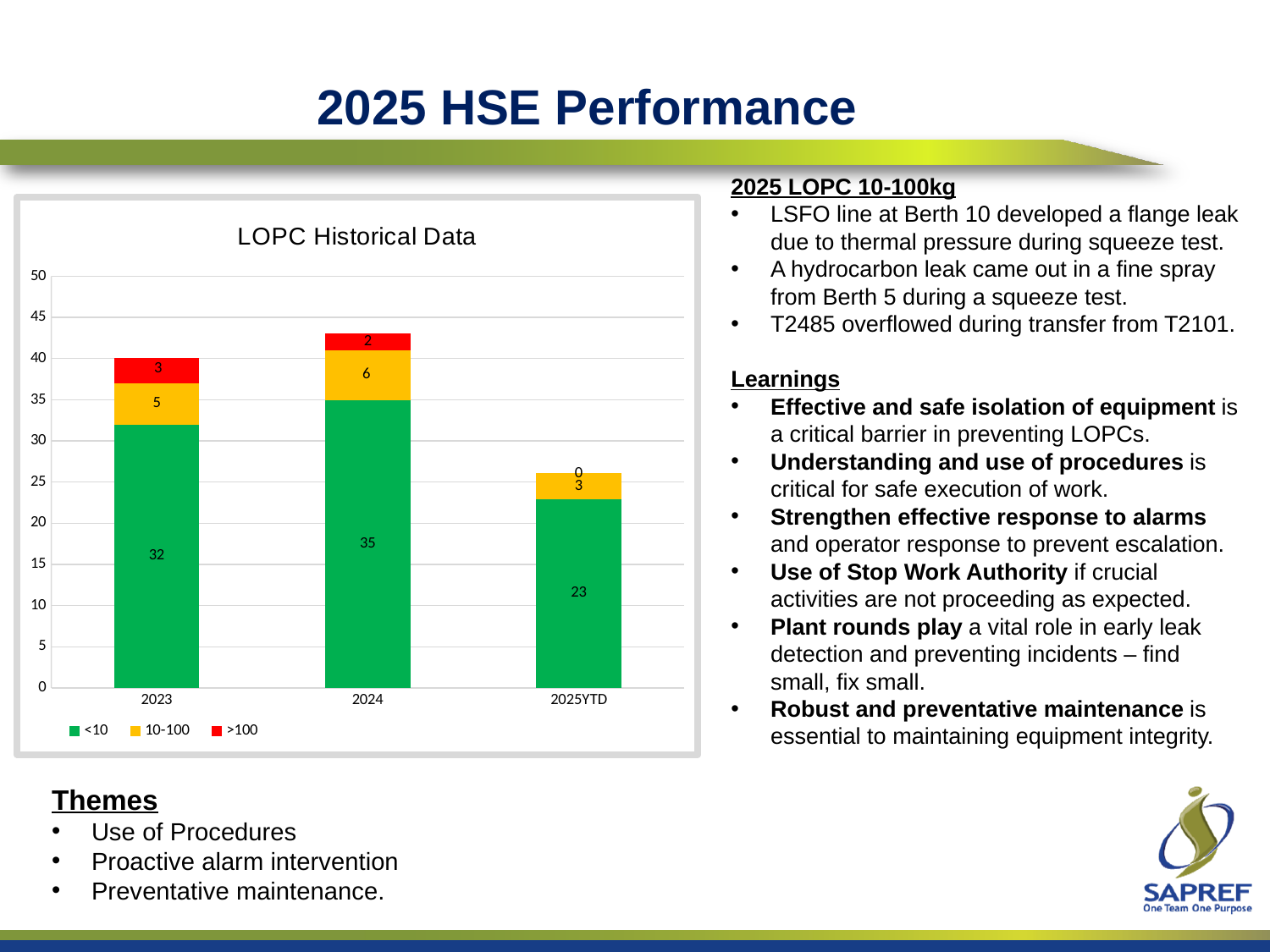
How many series does the chart legend list? 3 What is the difference between the <10 values for 2024 and 2025YTD? 12 Which is larger, the >100 value for 2023 or for 2024? 2023 Which year has the highest value for the <10 series? 2024 What is the value of the >100 series for 2025YTD? 0 What kind of chart is shown on the slide? Stacked bar chart How many categories are shown on the x axis of the chart? 3 What is the total of the stacked bar for 2023? 40 Which category has the lowest value for the 10-100 series? 2025YTD What is the value of the <10 series for 2024? 35 What is the value of the 10-100 series for 2023? 5 What is the title of the chart? LOPC Historical Data